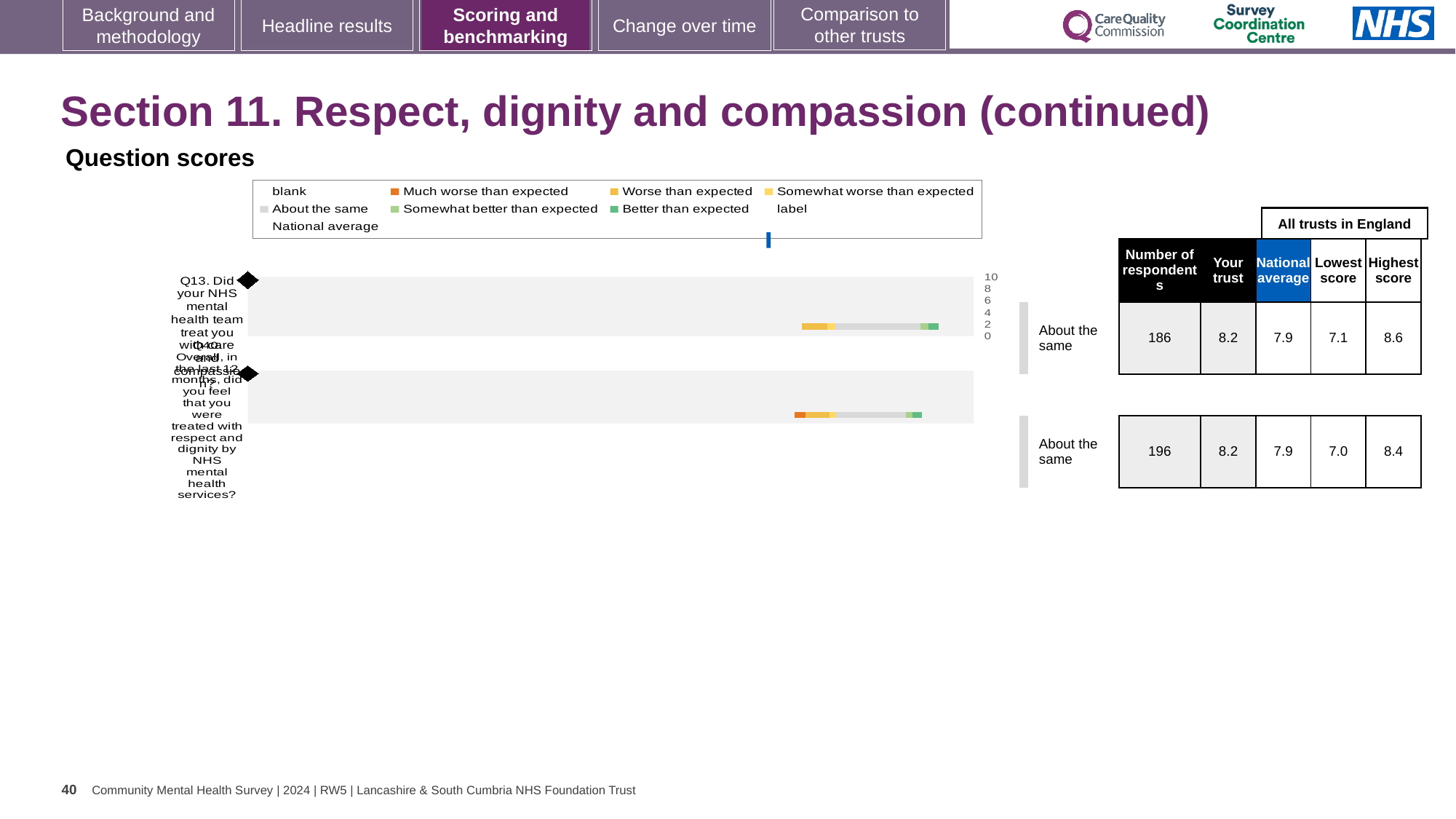
What is the 'Your trust' score for Q13? 8.2 What is the number of respondents for Q13 in the table next to the chart? 186 Which question has the higher highest score, Q13 or Q14? Q13 What is the lowest score among all trusts in England for Q14? 7.0 What is the difference between the highest score and the lowest score for Q14? 1.4 What colour represents 'Much worse than expected' in the chart legend? orange What benchmark category is shown for both Q13 and Q14? About the same How many questions are plotted in the question scores chart? 2 What is the national average score for Q14? 7.9 What is the number of respondents for Q14 in the table next to the chart? 196 What kind of chart is used to show the question scores on this slide? bar chart What is the highest score among all trusts in England for Q13? 8.6